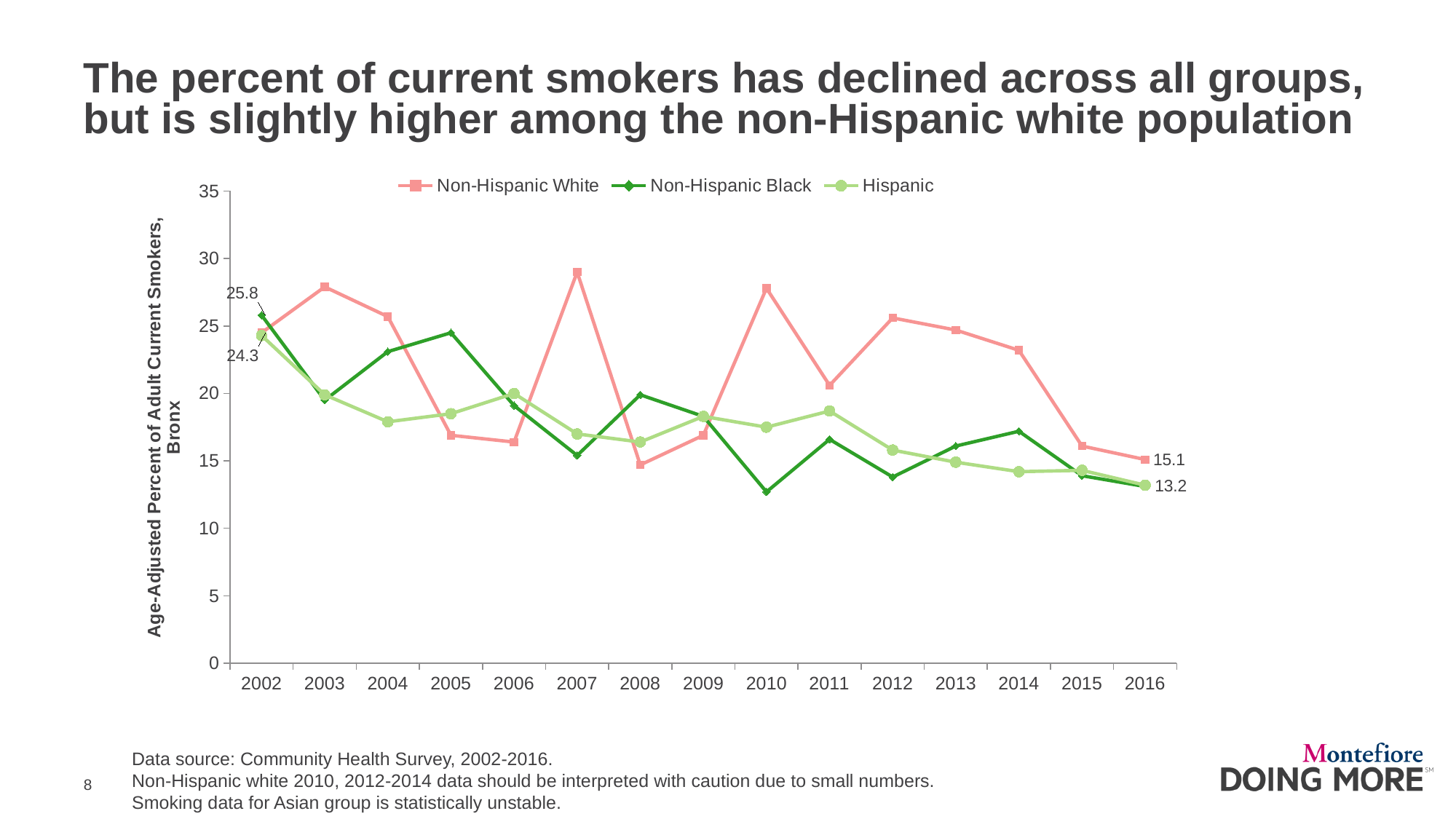
What is the difference between the two values labeled at 2016 (15.1 and 13.2)? 1.9 Which series has the lowest value in 2010? Non-Hispanic Black In 2005, which is larger: the value for Non-Hispanic Black or the value for Hispanic? Non-Hispanic Black How many years are shown along the x axis? 15 What is the labeled value for Non-Hispanic Black in 2002? 25.8 What kind of chart is shown on the slide? Line chart Is the value for Non-Hispanic Black in 2010 greater or less than 15? less Is the value for Non-Hispanic White in 2007 greater or less than 25? greater Which series has the highest value in 2007? Non-Hispanic White How many series does the legend list? 3 What is the labeled value for Non-Hispanic White in 2016? 15.1 Does the Non-Hispanic White line rise or fall from 2014 to 2016? Fall